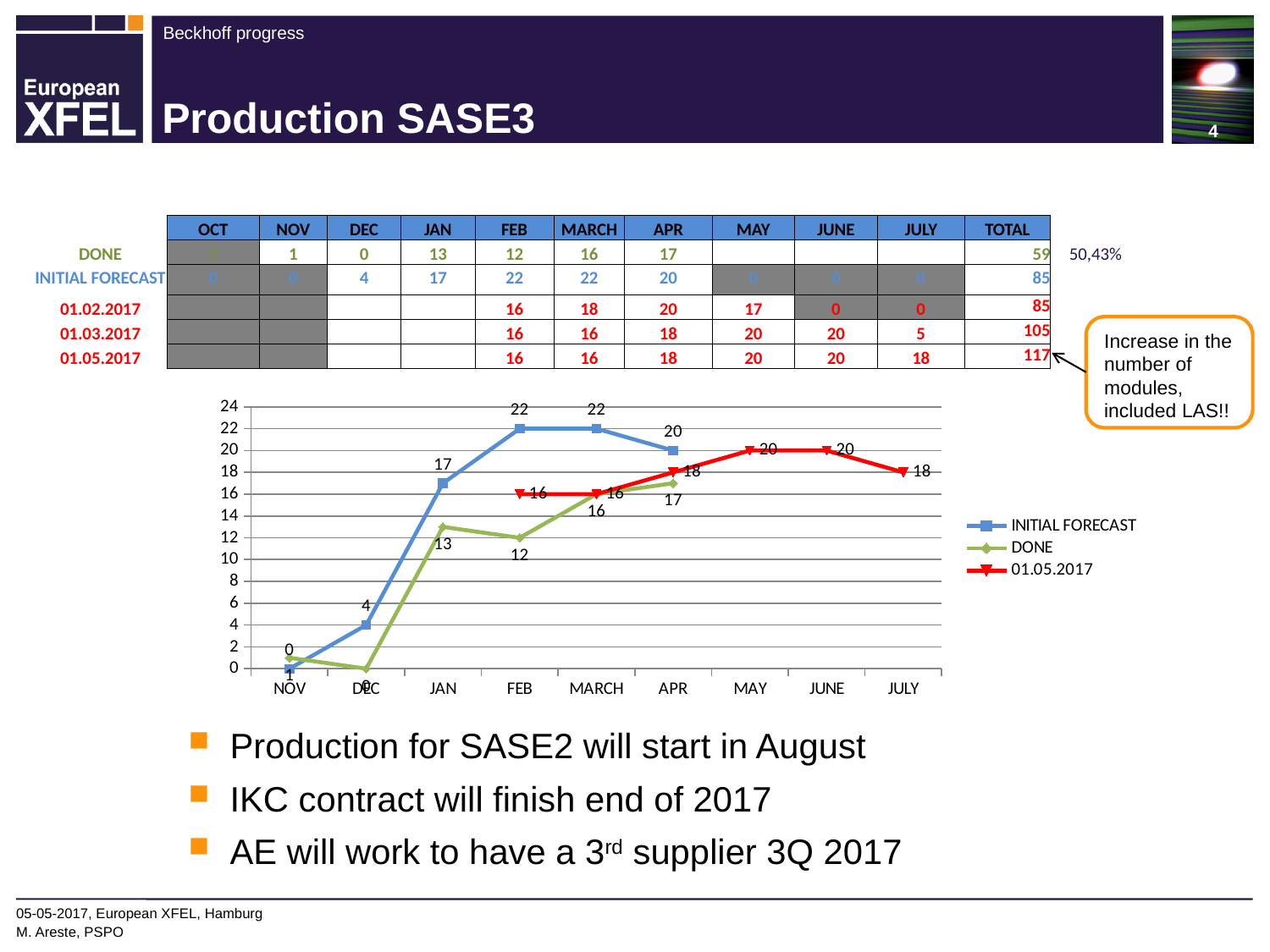
What is the INITIAL FORECAST value for JAN in the chart? 17 What is the 01.05.2017 value for JULY in the chart? 18 What type of chart is shown on the slide? line chart What is the lowest value of the DONE series in the chart? 0 Which is larger in the chart for APR: the INITIAL FORECAST value or the DONE value? INITIAL FORECAST How many months are shown on the x axis of the chart? 9 What is the DONE value for MARCH in the chart? 16 In which month does the INITIAL FORECAST series reach its highest value in the chart? FEB and MARCH How many series does the chart legend list? 3 What is the difference between the INITIAL FORECAST and DONE values for FEB in the chart? 10 Which colour is used for the 01.05.2017 series in the chart? red Does the DONE series rise or fall from DEC to JAN in the chart? rise